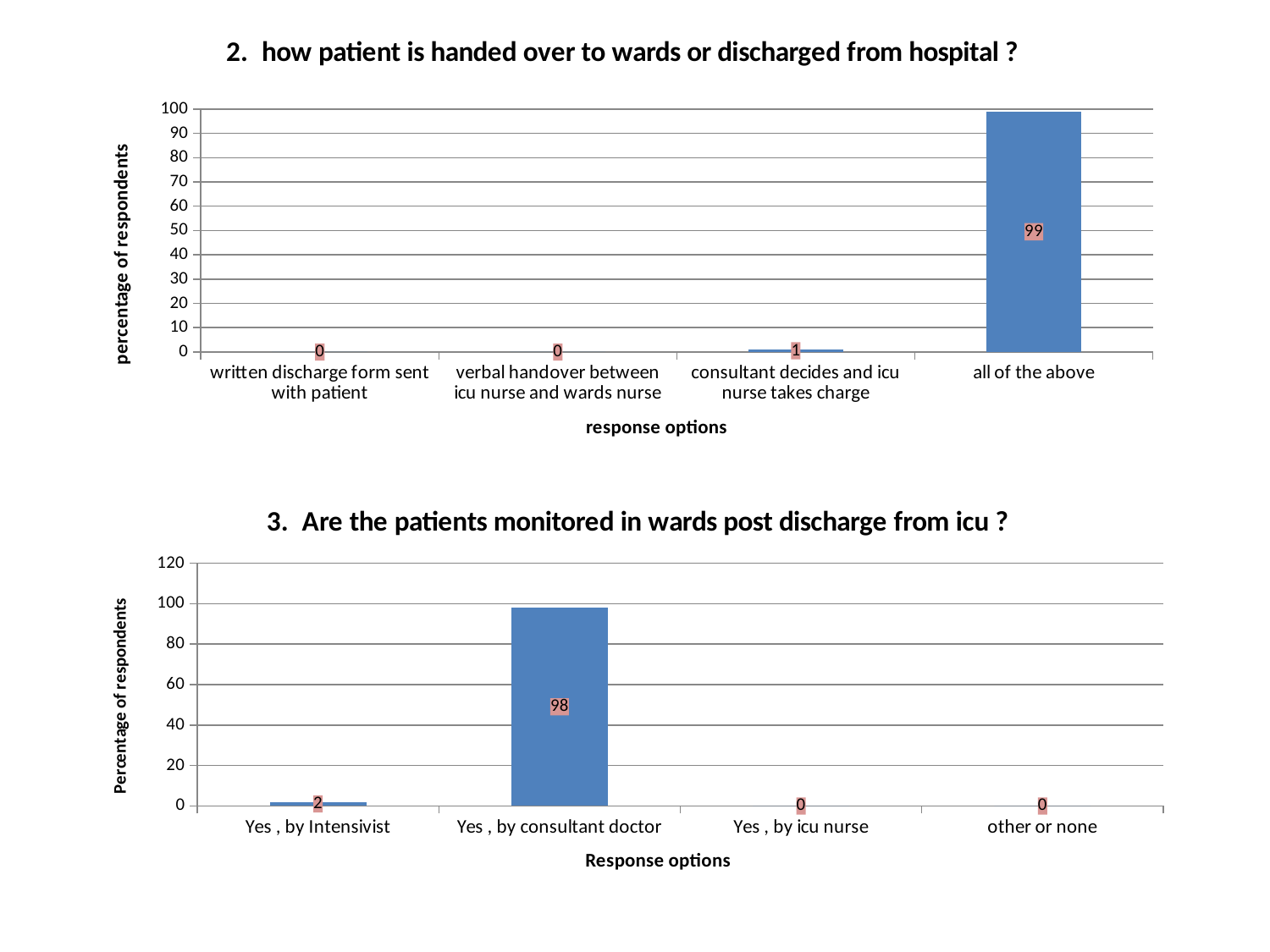
In the top chart (how patient is handed over to wards or discharged from hospital), what is the label of the y axis? percentage of respondents In the bottom chart (Are the patients monitored in wards post discharge from icu), what is the value for 'Yes , by consultant doctor'? 98 In the bottom chart (Are the patients monitored in wards post discharge from icu), what is the value for 'Yes , by Intensivist'? 2 In the top chart (how patient is handed over to wards or discharged from hospital), how many response options are shown on the x axis? 4 In the bottom chart (Are the patients monitored in wards post discharge from icu), which is larger: 'Yes , by Intensivist' or 'Yes , by consultant doctor'? Yes , by consultant doctor In the top chart (how patient is handed over to wards or discharged from hospital), what is the value for 'consultant decides and icu nurse takes charge'? 1 What kind of chart is the bottom chart (Are the patients monitored in wards post discharge from icu)? bar chart In the bottom chart (Are the patients monitored in wards post discharge from icu), which response option has the highest value? Yes , by consultant doctor In the top chart (how patient is handed over to wards or discharged from hospital), which response option has the highest value? all of the above In the bottom chart (Are the patients monitored in wards post discharge from icu), what is the difference between 'Yes , by consultant doctor' and 'Yes , by Intensivist'? 96 In the top chart (how patient is handed over to wards or discharged from hospital), what is the value for 'all of the above'? 99 In the top chart (how patient is handed over to wards or discharged from hospital), what is the difference between 'all of the above' and 'consultant decides and icu nurse takes charge'? 98